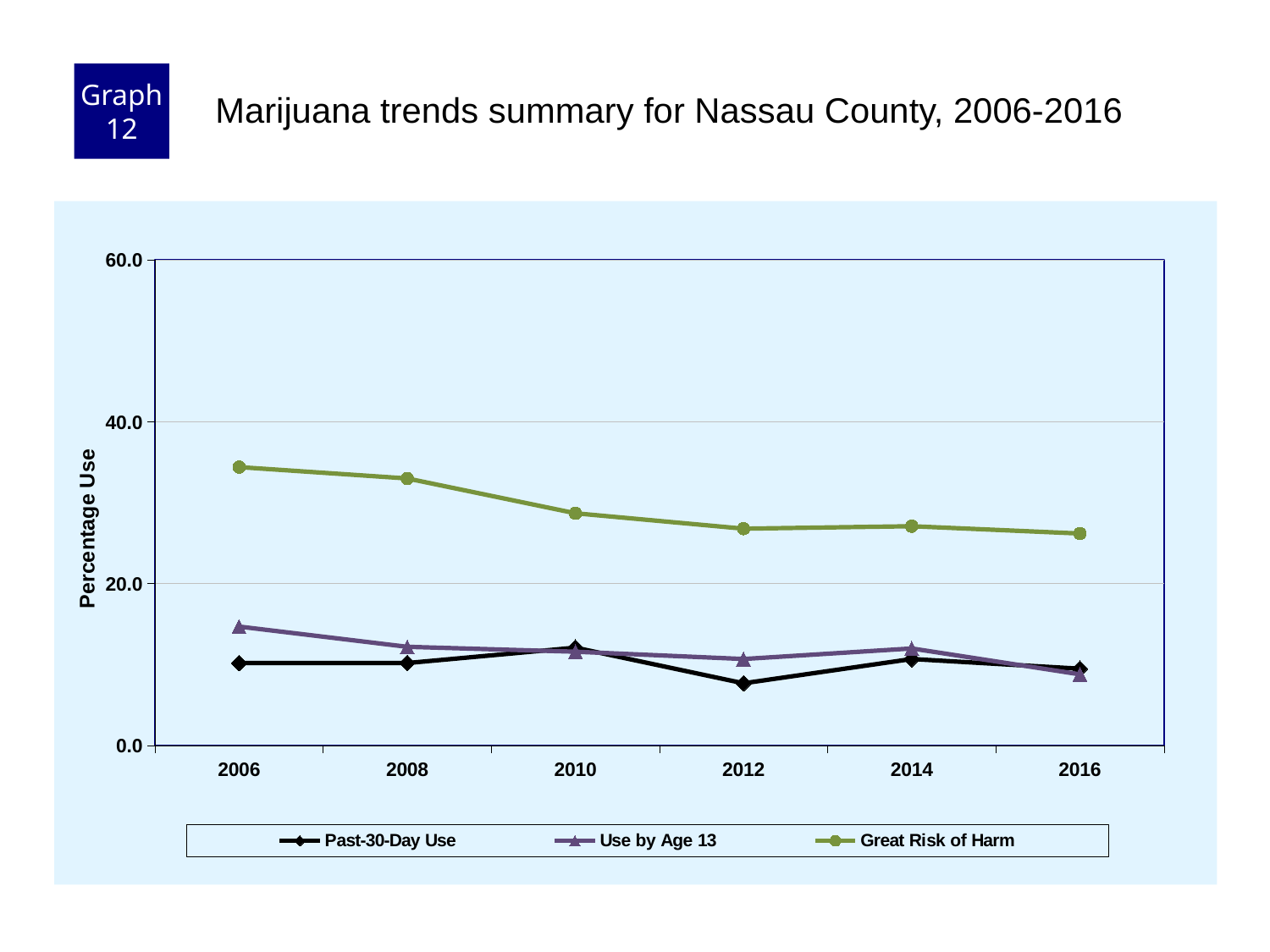
What kind of chart is shown on the slide? line chart In which year is the Great Risk of Harm series at its highest? 2006 How many series does the legend list? 3 Is the value for Past-30-Day Use in 2012 greater or less than 20.0? less Is the value for Great Risk of Harm in 2006 greater or less than 40.0? less What is the label on the y axis? Percentage Use Does the Great Risk of Harm series rise or fall from 2006 to 2016? fall What is the title of the chart? Marijuana trends summary for Nassau County, 2006-2016 In which year is the Use by Age 13 series at its highest? 2006 In 2012, which is larger: Great Risk of Harm or Past-30-Day Use? Great Risk of Harm How many years are plotted along the x axis? 6 Is the value for Great Risk of Harm in 2016 greater or less than 20.0? greater